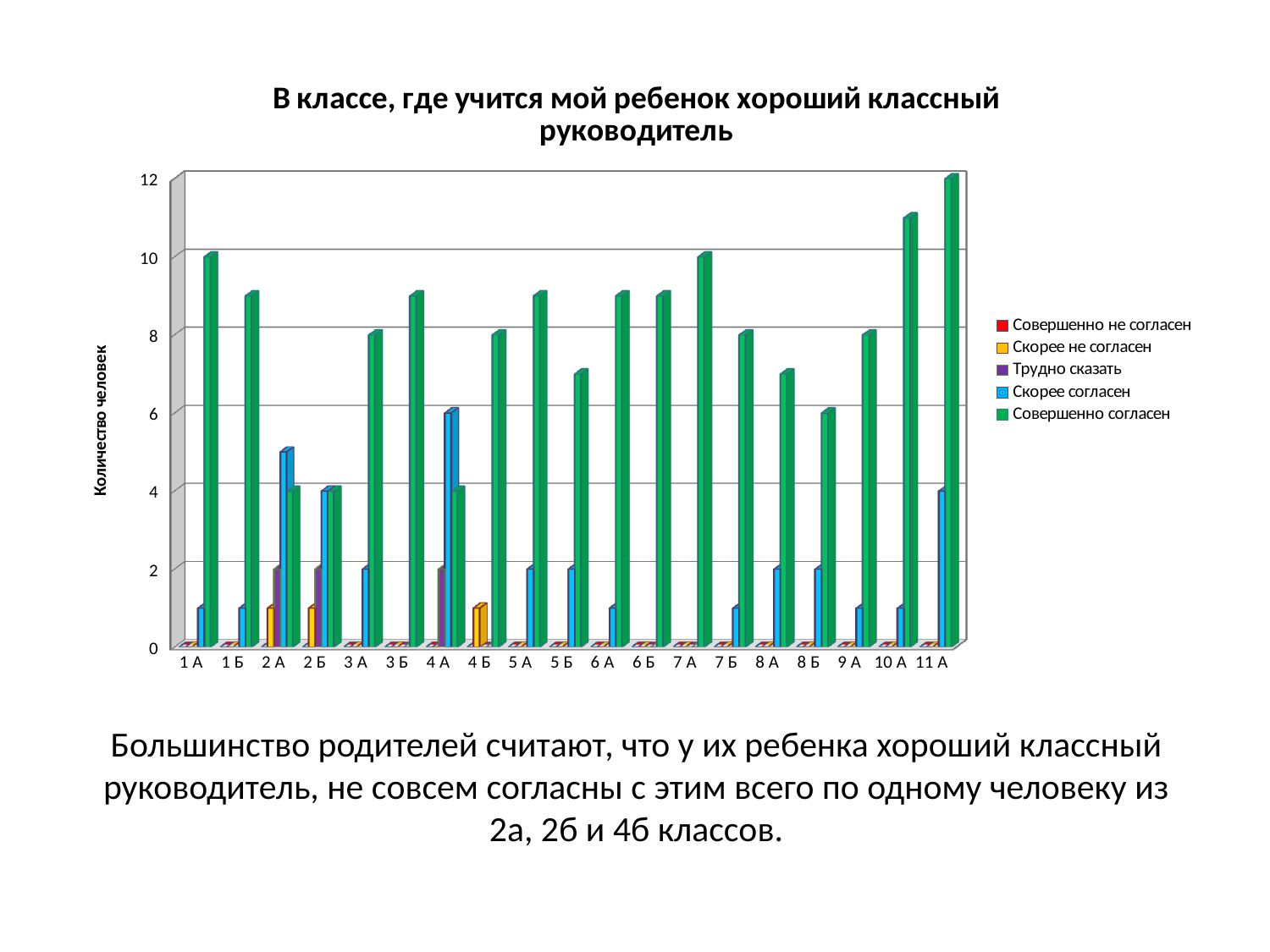
Which class has the lowest value for "Совершенно согласен"? 2 А, 2 Б and 4 А (tied at 4) What kind of chart is shown on the slide? bar chart What is the title of the chart? В классе, где учится мой ребенок хороший классный руководитель Which is larger: the "Совершенно согласен" value for 11 А or for 8 Б? 11 А Which class has the highest value for "Совершенно согласен"? 11 А What is the label of the vertical axis? Количество человек How many series does the legend list? 5 Is the value for "Совершенно согласен" in 11 А greater or less than 10? greater How many class categories are shown on the x axis? 19 Is the value for "Совершенно согласен" in 8 Б greater or less than 8? less Is the value for "Скорее согласен" in 4 А greater or less than 4? greater